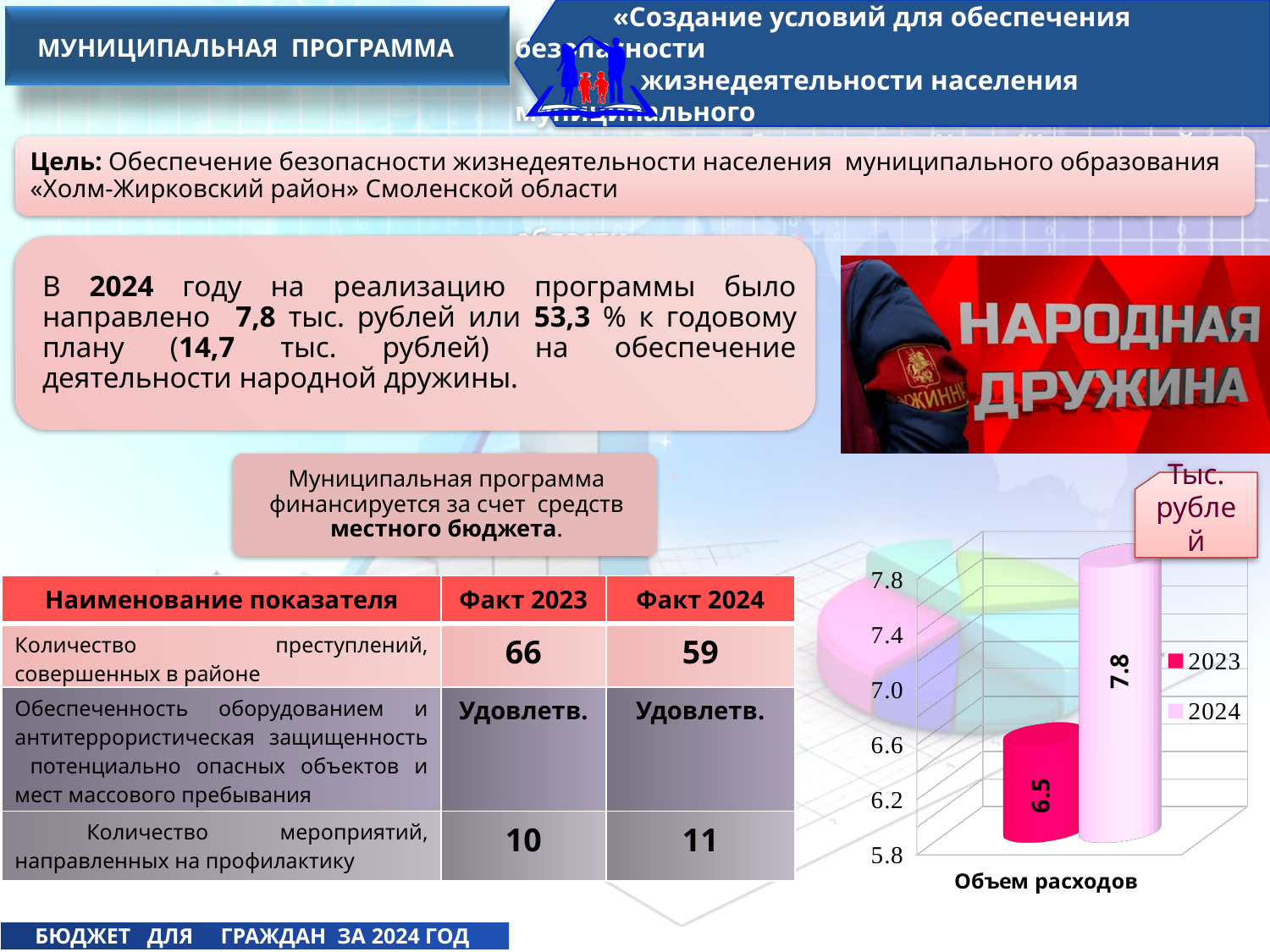
Which series has the lowest value in the chart? 2023 What kind of chart is shown on the slide? bar chart Which year has the higher value in the chart, 2023 or 2024? 2024 What is the value for 2024 in the chart? 7.8 Is the value for 2024 greater or less than 7.4? greater What is the difference between the 2024 and 2023 values in the chart? 1.3 Which series has the highest value in the chart? 2024 Is the value for 2023 greater or less than 7.0? less What is the category label shown below the bars in the chart? Объем расходов How many series does the chart legend list? 2 What is the value for 2023 in the chart? 6.5 What unit is indicated for the chart values? Тыс. рублей